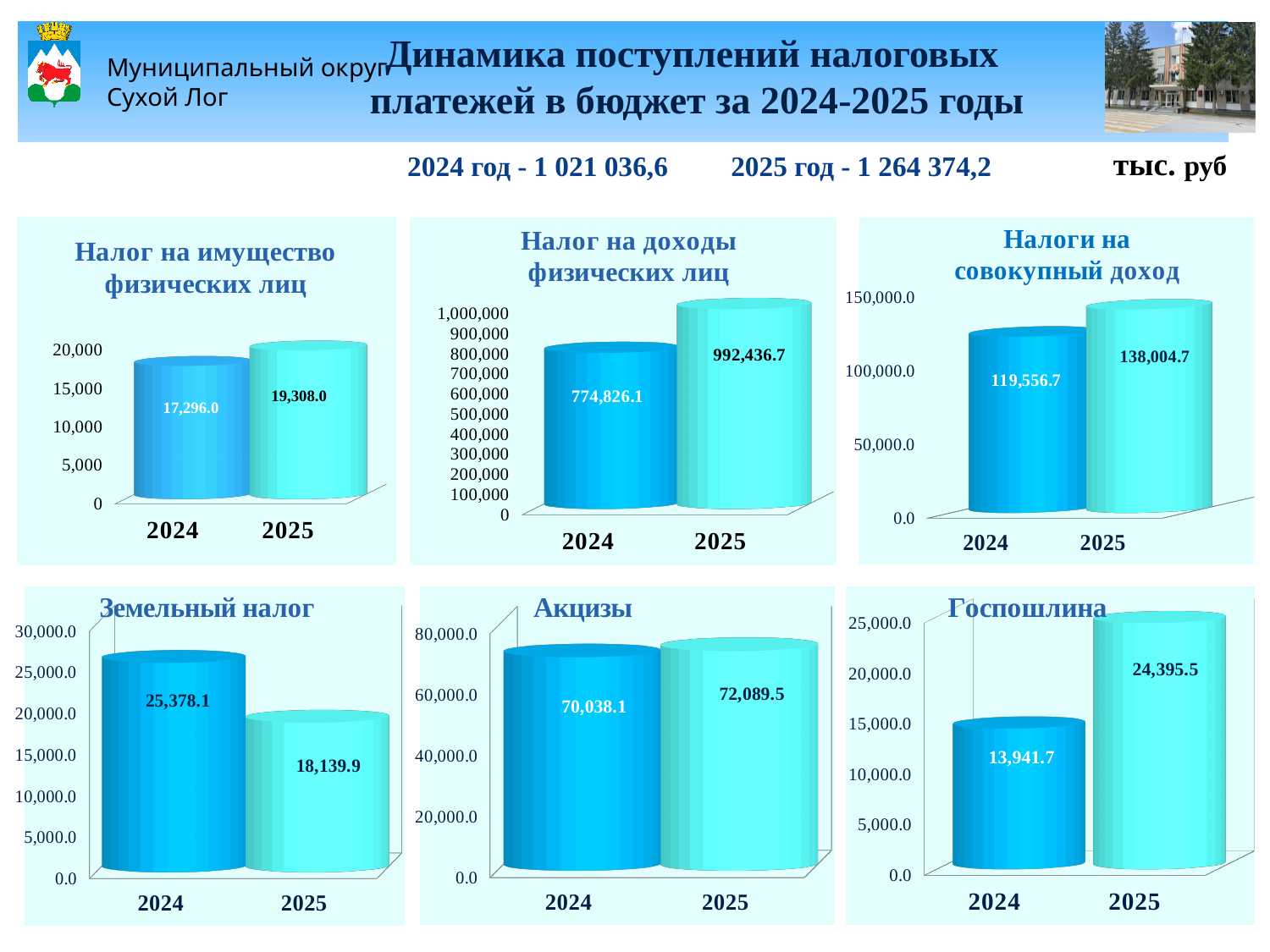
In the chart titled "Акцизы", what is the difference between the 2025 and 2024 values? 2,051.4 In the chart titled "Налоги на совокупный доход", what is the value for 2025? 138,004.7 How many categories (years) are shown in the chart titled "Акцизы"? 2 In the chart titled "Госпошлина", which year has the lower value? 2024 In the chart titled "Земельный налог", which year has the higher value? 2024 In the chart titled "Налог на доходы физических лиц", is the value for 2025 larger or smaller than the value for 2024? larger What kind of chart is the one titled "Налоги на совокупный доход"? bar chart In the chart titled "Налог на имущество физических лиц", what is the value for 2025? 19,308.0 In the chart titled "Налог на доходы физических лиц", what is the value for 2024? 774,826.1 In the chart titled "Земельный налог", is the value for 2025 greater or less than 20,000.0? less In the chart titled "Земельный налог", do the values rise or fall from 2024 to 2025? fall In the chart titled "Госпошлина", what is the difference between the 2025 and 2024 values? 10,453.8